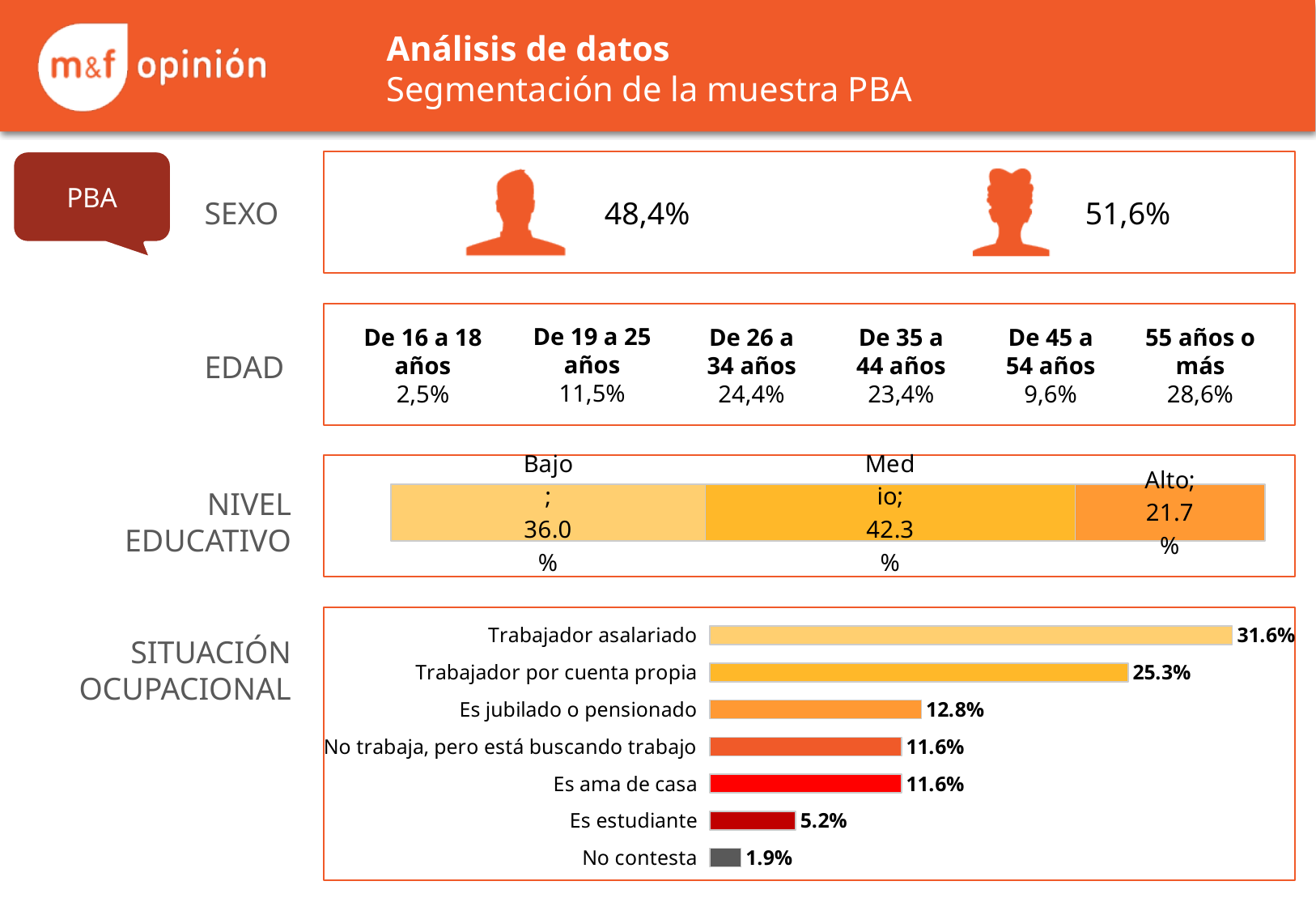
In the Nivel educativo stacked bar chart, what is the difference between Bajo and Alto? 14.3% In the Situación ocupacional bar chart, which is larger: Es estudiante or No contesta? Es estudiante In the Situación ocupacional bar chart, which category has the lowest value? No contesta How many categories are shown in the Situación ocupacional bar chart? 7 In the Situación ocupacional bar chart, what is the difference between Trabajador asalariado and Trabajador por cuenta propia? 6.3% In the Situación ocupacional bar chart, what is the value for Trabajador asalariado? 31.6% In the Nivel educativo stacked bar chart, what is the value for Medio? 42.3% In the Situación ocupacional bar chart, what is the value for Es jubilado o pensionado? 12.8% In the Nivel educativo stacked bar chart, what is the value for Alto? 21.7% What kind of chart is used for Situación ocupacional? Bar chart In the Nivel educativo stacked bar chart, which segment is the largest? Medio In the Situación ocupacional bar chart, which category has the highest value? Trabajador asalariado